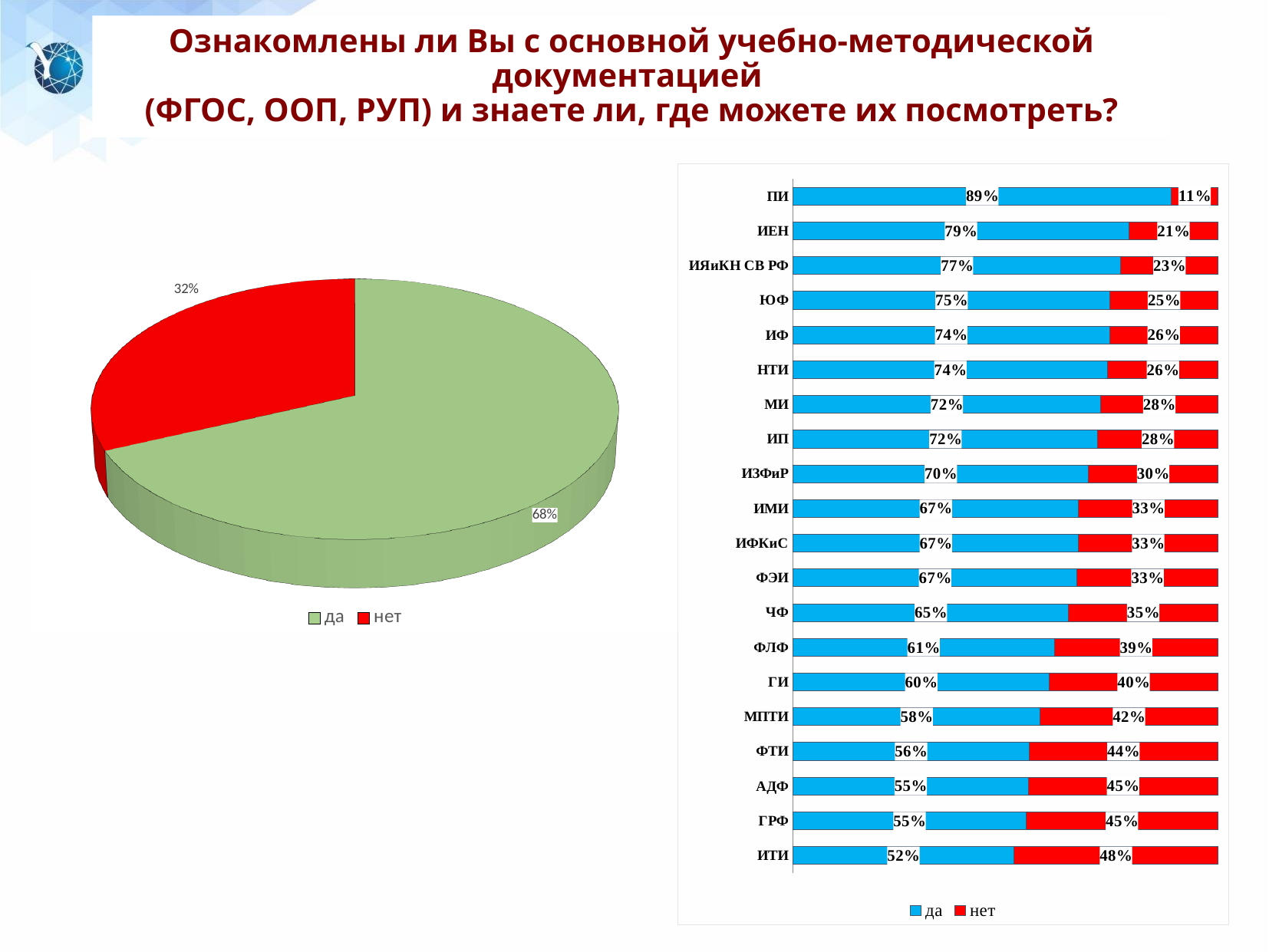
What kind of chart is the chart on the right of the slide? Bar chart In the pie chart on the left, what share of the pie is labelled "да"? 68% In the bar chart on the right, which category has the highest "да" value? ПИ In the bar chart on the right, what is the difference between the "да" values for ИЕН and ГИ? 19% In the bar chart on the right, which category has the lowest "да" value? ИТИ In the bar chart on the right, what is the "нет" value for ИТИ? 48% How many series does the legend of the bar chart on the right list? 2 What kind of chart is the chart on the left of the slide? Pie chart In the pie chart on the left, what share of the pie is labelled "нет"? 32% In the bar chart on the right, which is larger: the "нет" value for ФЛФ or the "нет" value for ЧФ? ФЛФ How many categories are shown in the bar chart on the right? 20 In the bar chart on the right, what is the "да" value for ПИ? 89%